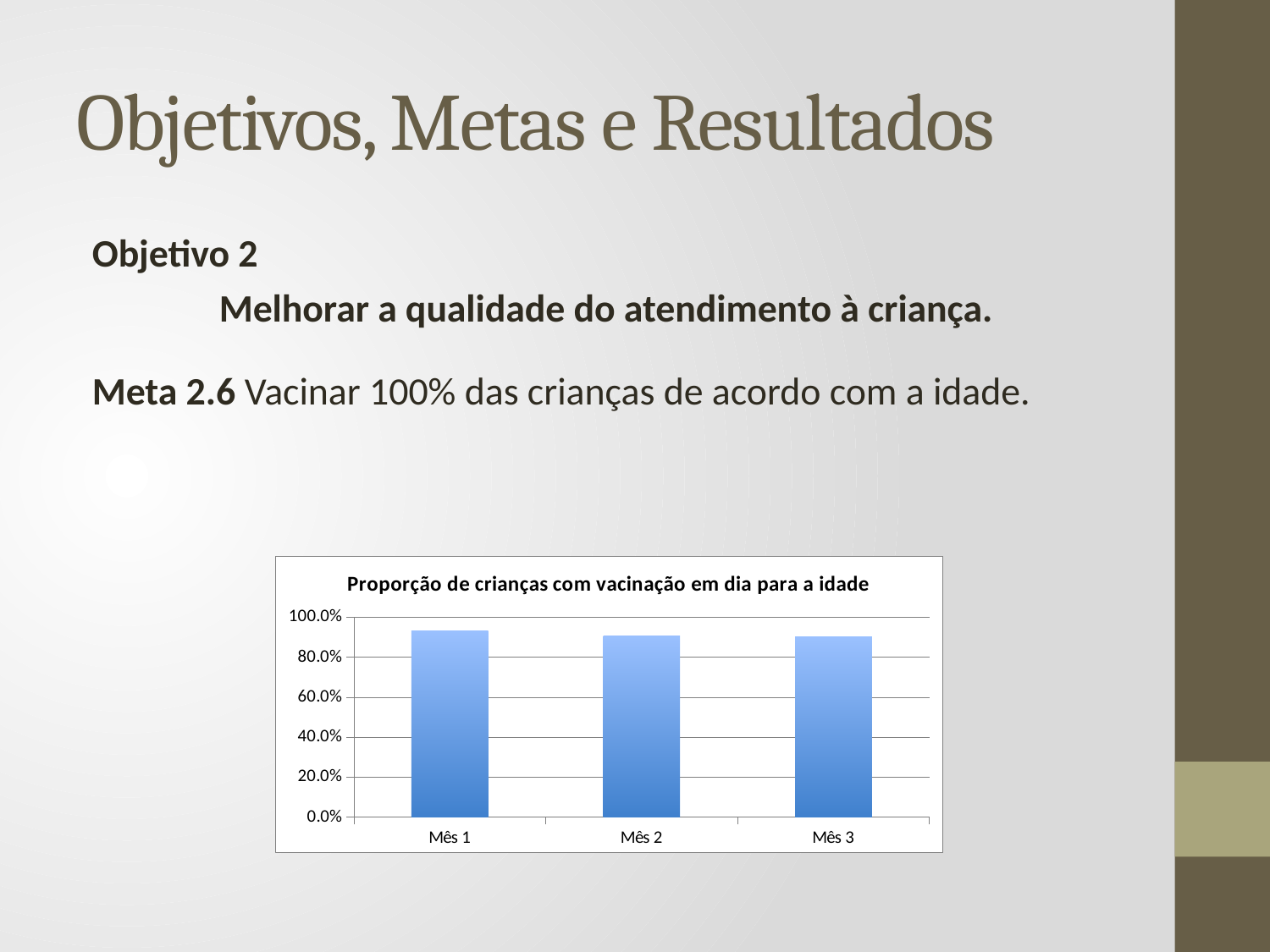
What kind of chart is shown on the slide? bar chart Is the value for Mês 2 greater or less than 80.0%? greater What is the label of the first category on the x axis? Mês 1 How many categories are shown on the x axis of the chart? 3 Is the value for Mês 1 greater or less than 80.0%? greater Is the value for Mês 1 greater or less than 100.0%? less What is the title of the chart? Proporção de crianças com vacinação em dia para a idade What is the highest value shown on the y axis of the chart? 100.0%